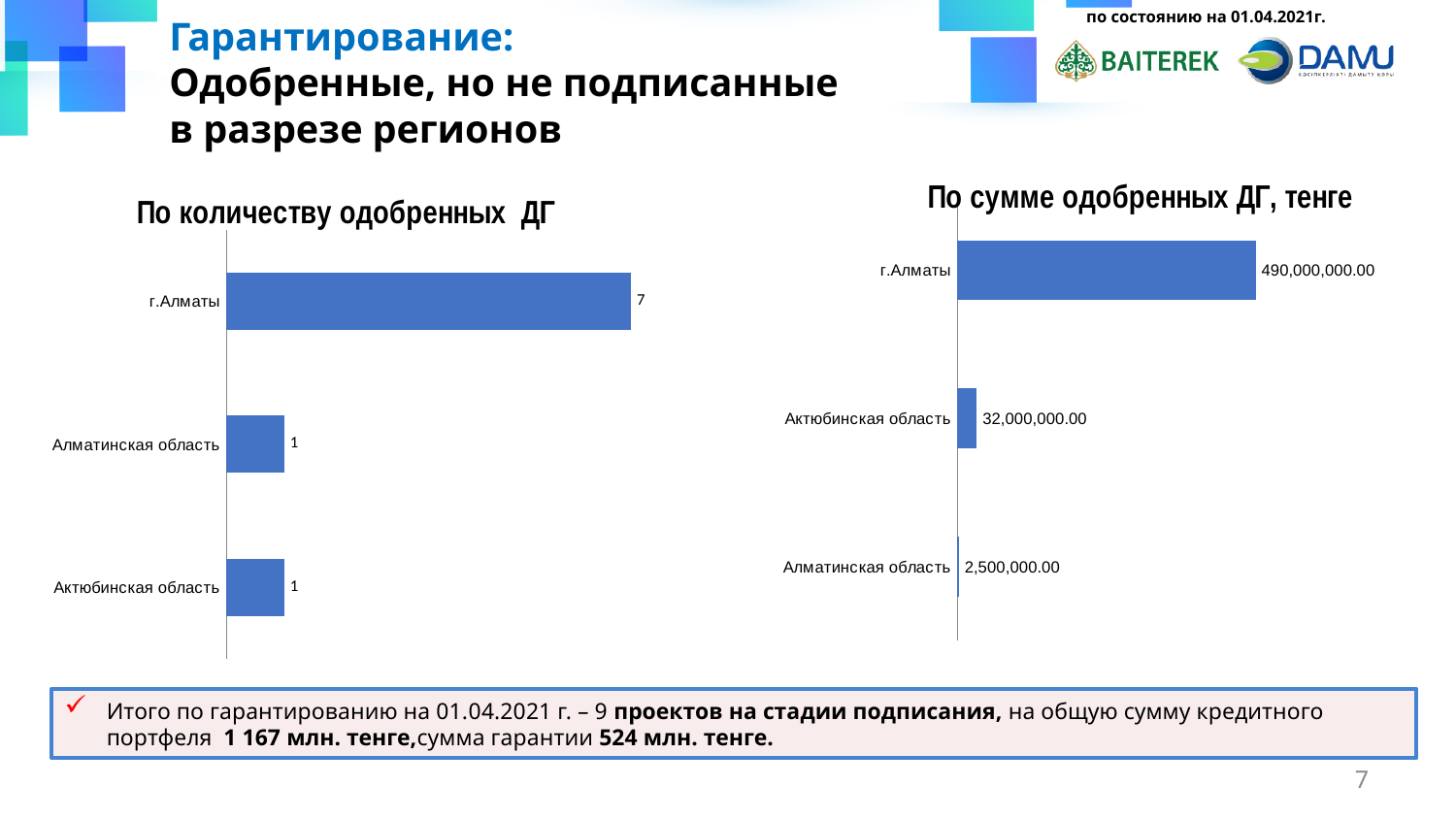
In the chart 'По сумме одобренных ДГ, тенге', what is the value for г.Алматы? 490,000,000.00 In the chart 'По количеству одобренных ДГ', what is the difference between г.Алматы and Актюбинская область? 6 How many regions are shown in the chart 'По количеству одобренных ДГ'? 3 In the chart 'По сумме одобренных ДГ, тенге', which region has the lowest value? Алматинская область In the chart 'По количеству одобренных ДГ', what is the value for Алматинская область? 1 In the chart 'По количеству одобренных ДГ', which region has the highest value? г.Алматы What type of chart is 'По сумме одобренных ДГ, тенге'? Bar chart In the chart 'По количеству одобренных ДГ', what is the value for г.Алматы? 7 In the chart 'По сумме одобренных ДГ, тенге', what is the difference between г.Алматы and Актюбинская область? 458,000,000.00 In the chart 'По сумме одобренных ДГ, тенге', which is larger: Актюбинская область or Алматинская область? Актюбинская область In the chart 'По сумме одобренных ДГ, тенге', what is the value for Алматинская область? 2,500,000.00 In the chart 'По сумме одобренных ДГ, тенге', what is the value for Актюбинская область? 32,000,000.00